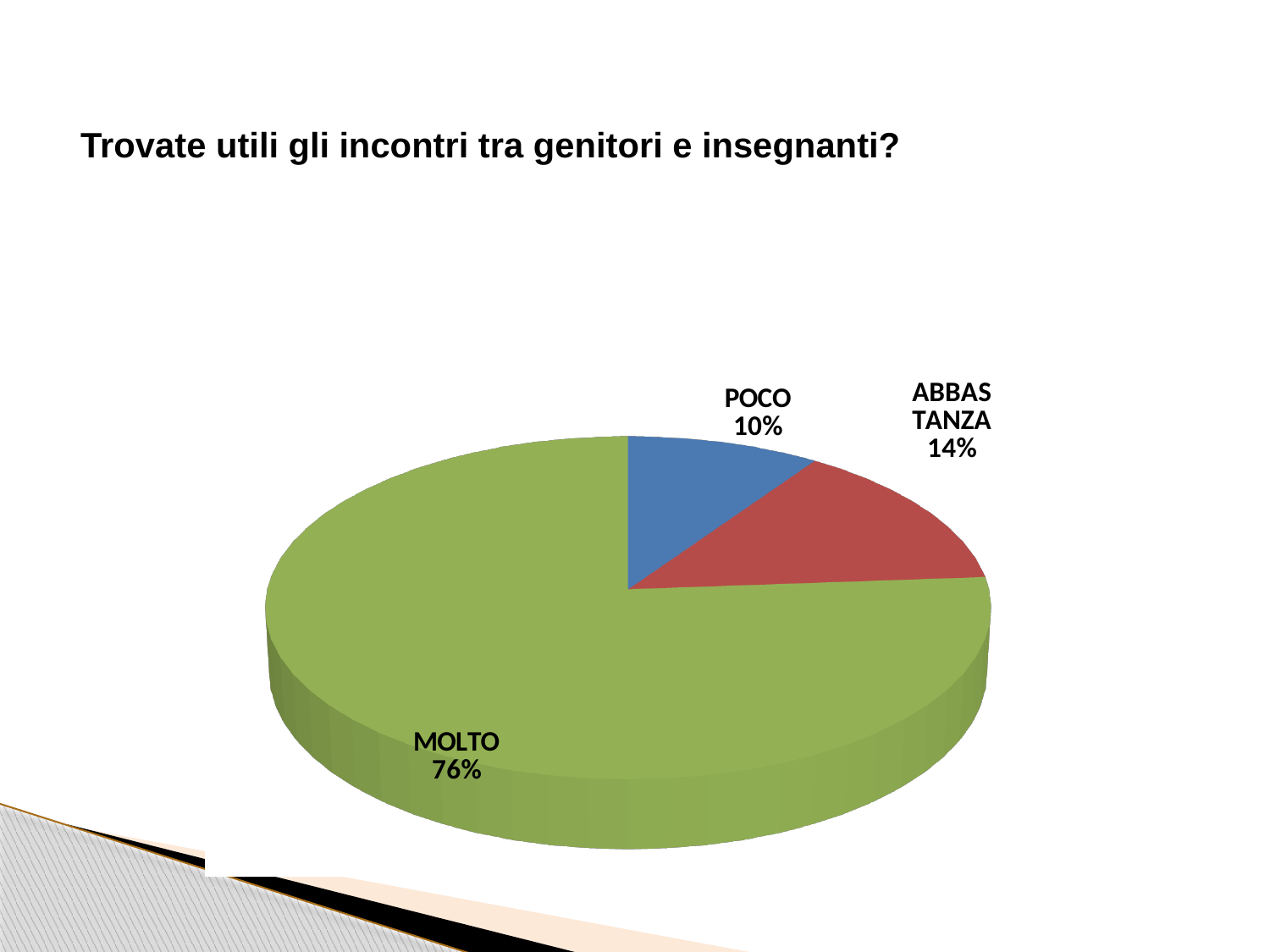
Which slice is larger, POCO or ABBASTANZA? ABBASTANZA What kind of chart is shown on the slide? pie chart What colour is the MOLTO slice of the pie? green Which slice of the pie is the smallest? POCO What percentage of the pie is labelled ABBASTANZA? 14% What is the difference in percentage points between the ABBASTANZA and POCO slices? 4 How many slices does the pie chart have? 3 Which slice of the pie is the largest? MOLTO What is the difference in percentage points between the MOLTO and ABBASTANZA slices? 62 What percentage of the pie is labelled MOLTO? 76% What percentage of the pie is labelled POCO? 10% What question is written as the title above the chart? Trovate utili gli incontri tra genitori e insegnanti?